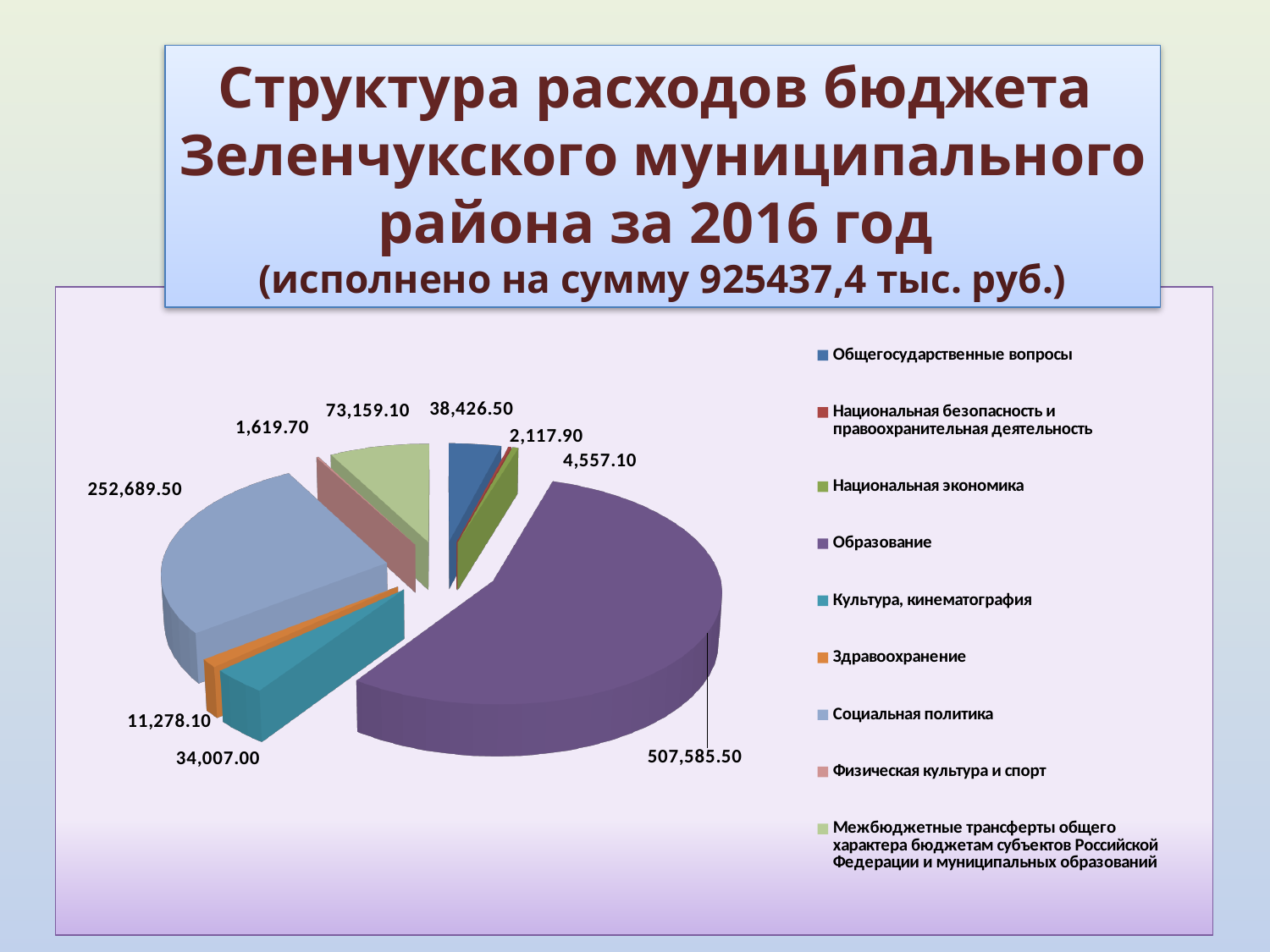
According to the slide title, what total amount was executed in the 2016 budget? 925437,4 тыс. руб. What type of chart is shown on the slide? pie chart What is the value for Образование? 507,585.50 Which is larger, the value for Общегосударственные вопросы or the value for Культура, кинематография? Общегосударственные вопросы Which category has the largest slice of the pie? Образование What is the value for Социальная политика? 252,689.50 What is the difference between the values for Образование and Социальная политика? 254,896.00 Which category has the smallest slice of the pie? Физическая культура и спорт What is the value for Здравоохранение? 11,278.10 What is the value for Культура, кинематография? 34,007.00 What is the difference between the values for Социальная политика and Межбюджетные трансферты общего характера бюджетам субъектов Российской Федерации и муниципальных образований? 179,530.40 How many categories does the legend of the pie chart list? 9